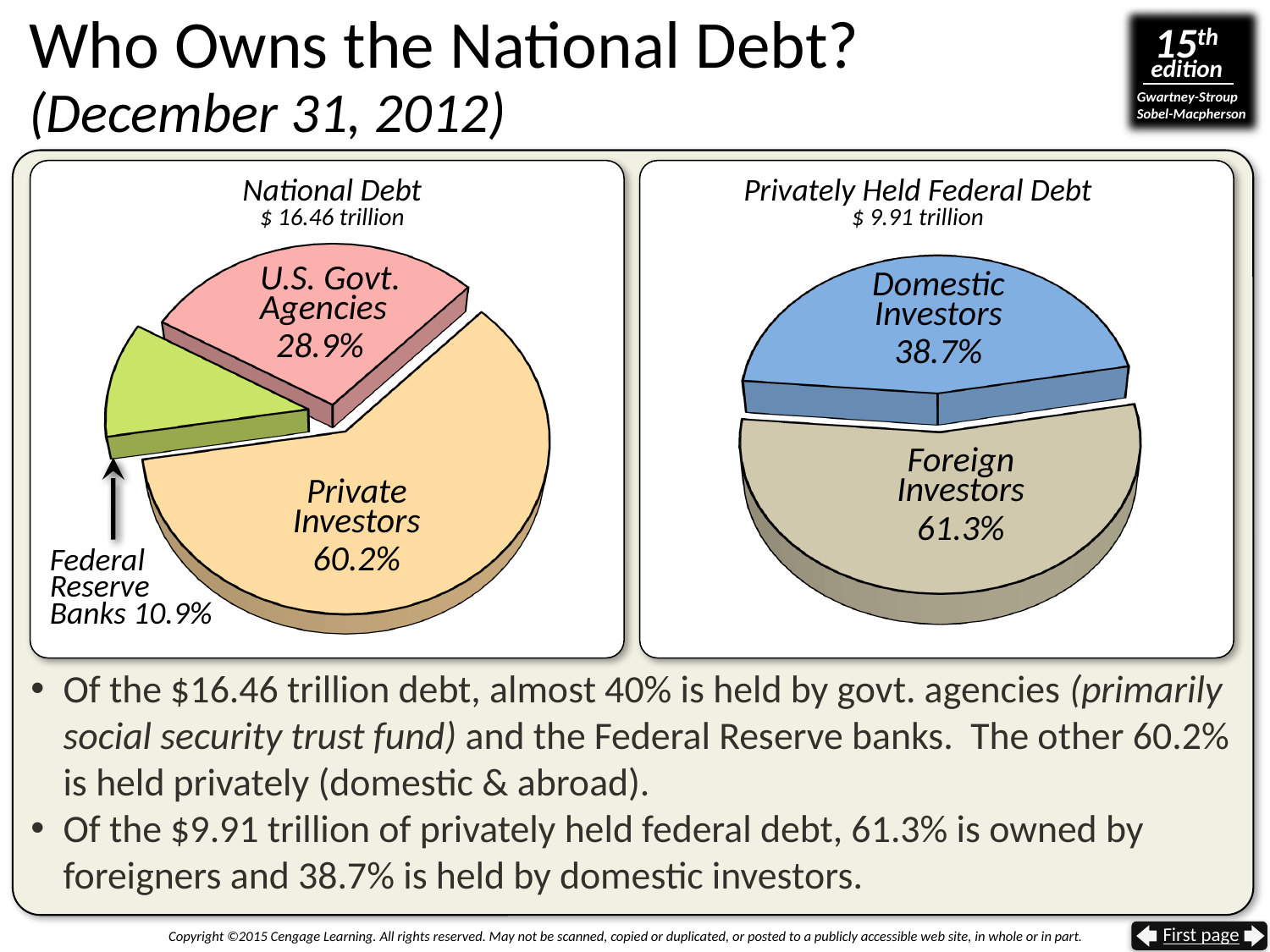
In the Privately Held Federal Debt pie chart, what is the difference in percentage points between Foreign Investors and Domestic Investors? 22.6 percentage points In the Privately Held Federal Debt pie chart, what share is held by Foreign Investors? 61.3% In the National Debt pie chart, which slice is the smallest? Federal Reserve Banks What type of chart is used on the left side of the slide for National Debt? Pie chart In the Privately Held Federal Debt pie chart, which is larger, Domestic Investors or Foreign Investors? Foreign Investors In the National Debt pie chart, which slice is the largest? Private Investors In the National Debt pie chart, what share is held by Private Investors? 60.2% In the National Debt pie chart, what is the difference in percentage points between the U.S. Govt. Agencies share and the Federal Reserve Banks share? 18.0 percentage points How many slices does the National Debt pie chart have? 3 In the National Debt pie chart, what share is held by Federal Reserve Banks? 10.9% In the Privately Held Federal Debt pie chart, what share is held by Domestic Investors? 38.7% In the National Debt pie chart, what share is held by U.S. Govt. Agencies? 28.9%